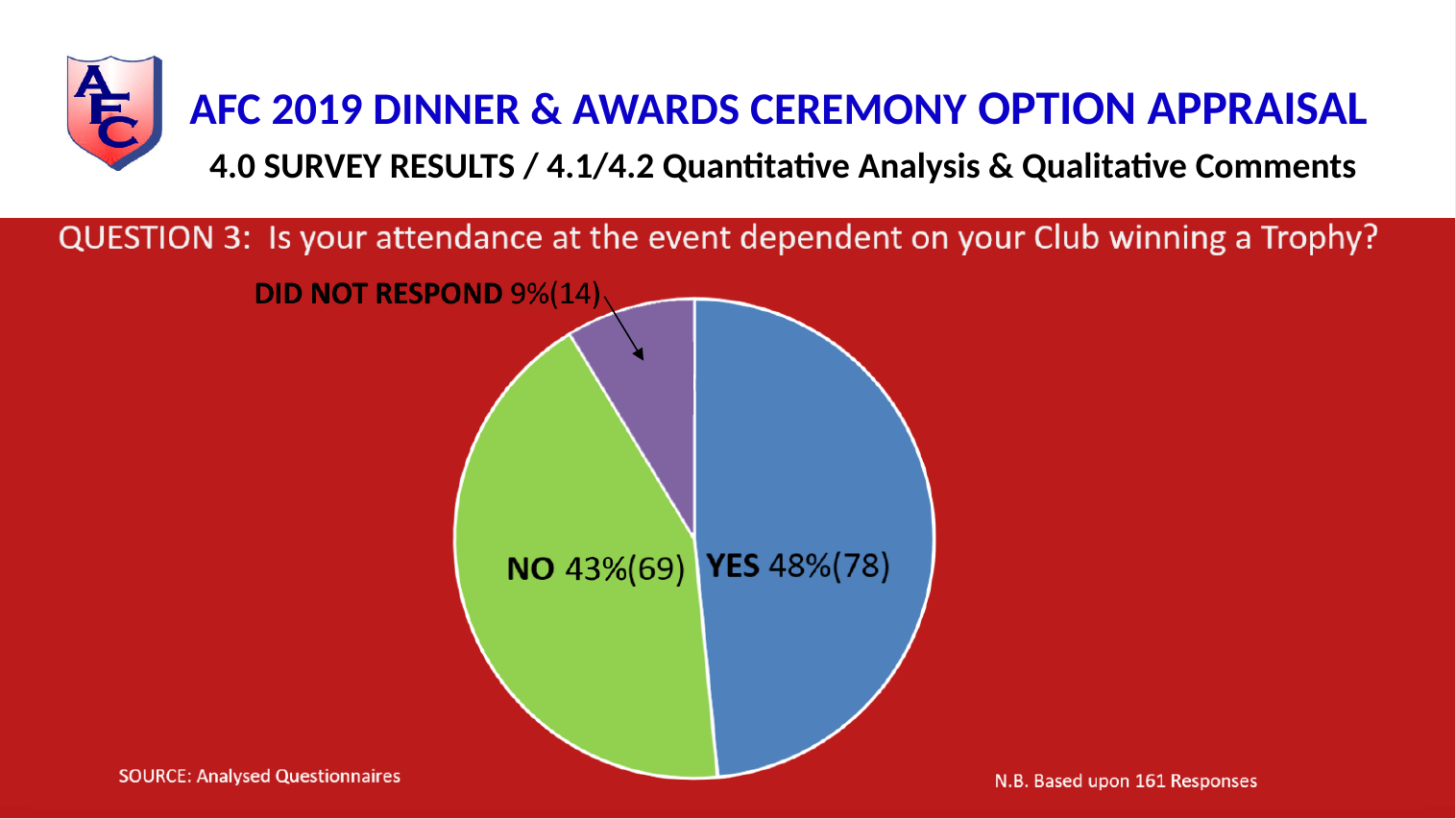
Which response has the largest slice of the pie? YES What share of the pie does the NO slice represent? 43% Which is larger, the NO slice or the DID NOT RESPOND slice? NO What colour is the YES slice? blue What kind of chart is shown on the slide? pie chart What percentage of respondents DID NOT RESPOND? 9% How many respondents answered YES? 78 How many respondents answered NO? 69 How many more respondents answered YES than NO? 9 How many slices does the pie chart have? 3 Which response has the smallest slice of the pie? DID NOT RESPOND What percentage of respondents answered YES? 48%